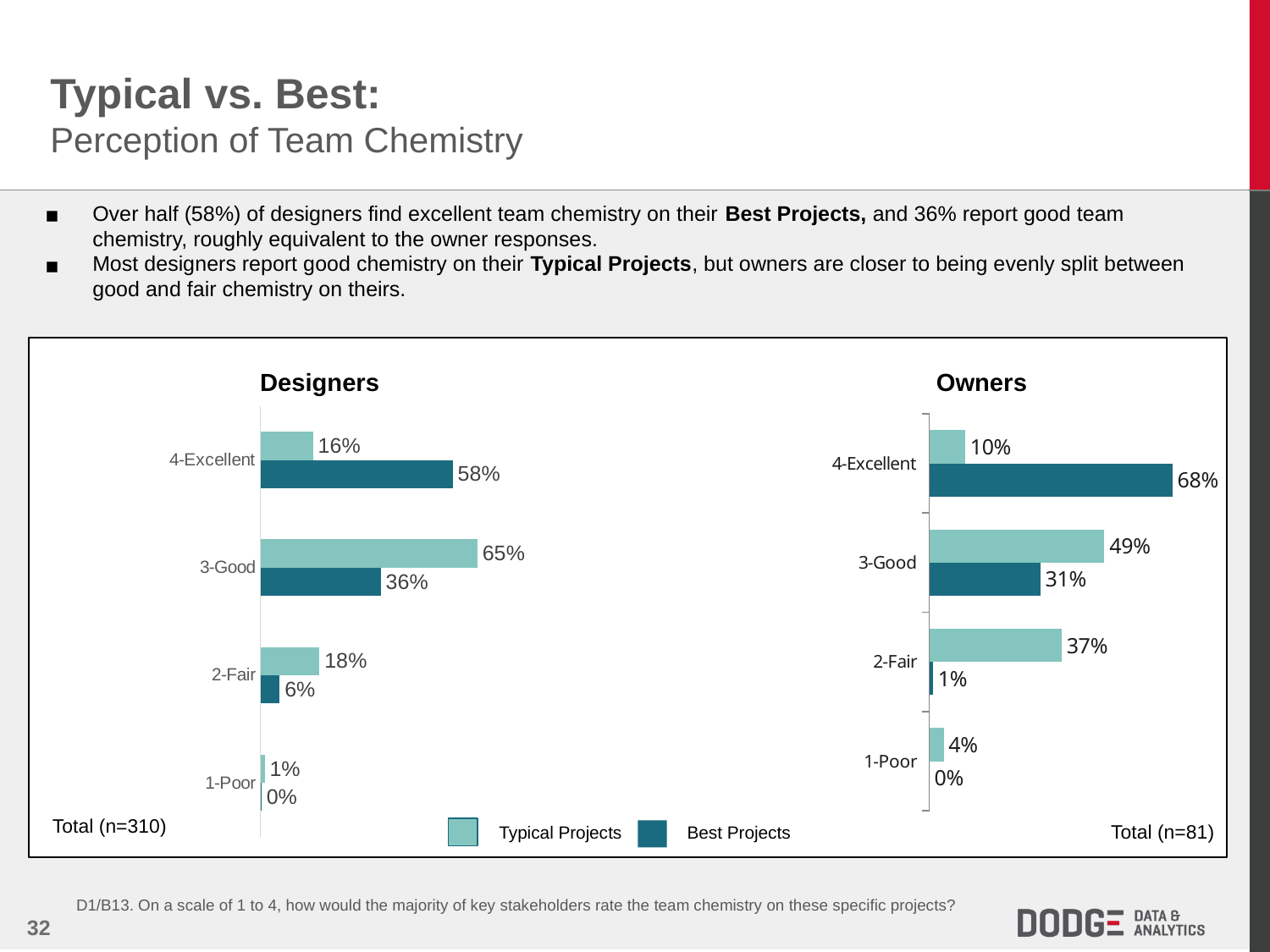
In the Owners chart, what percentage of Typical Projects are rated 3-Good? 49% In the Designers chart, what percentage of Best Projects are rated 4-Excellent? 58% In the Designers chart, what is the difference between the Typical Projects and Best Projects values for 3-Good? 29% In the Owners chart, which rating category has the lowest value for Typical Projects? 1-Poor In the Owners chart, what is the difference between the Best Projects and Typical Projects values for 4-Excellent? 58% In the Designers chart, which rating category has the highest value for Typical Projects? 3-Good What is the sample size (n) shown for the Owners chart? 81 How many series does the legend list? 2 In the Designers chart, which is larger for 2-Fair: Typical Projects or Best Projects? Typical Projects How many rating categories are shown in the Owners chart? 4 In the Owners chart, what percentage of Best Projects are rated 2-Fair? 1% What kind of chart is the Designers chart? Bar chart